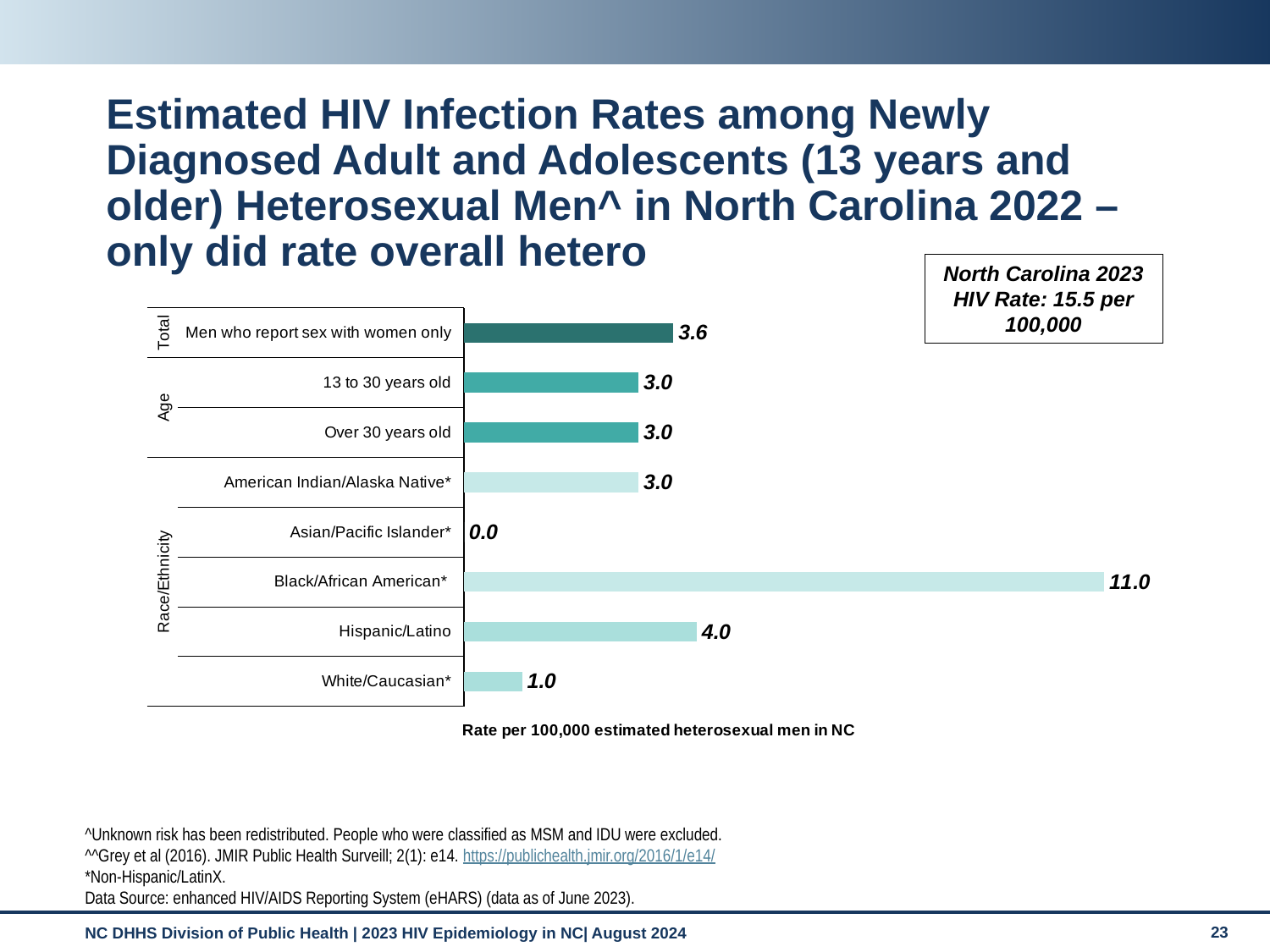
What is the rate for Asian/Pacific Islander*? 0.0 Which category has the highest rate? Black/African American* What is the rate for Hispanic/Latino? 4.0 How many categories are plotted in the chart? 8 What is the rate for White/Caucasian*? 1.0 Which is larger, the rate for Hispanic/Latino or the rate for White/Caucasian*? Hispanic/Latino What is the difference between the rates for Black/African American* and Hispanic/Latino? 7.0 What is the rate for Black/African American*? 11.0 What is the label of the horizontal axis of the chart? Rate per 100,000 estimated heterosexual men in NC Which category has the lowest rate? Asian/Pacific Islander* What is the rate for Men who report sex with women only? 3.6 What kind of chart is shown on the slide? Bar chart